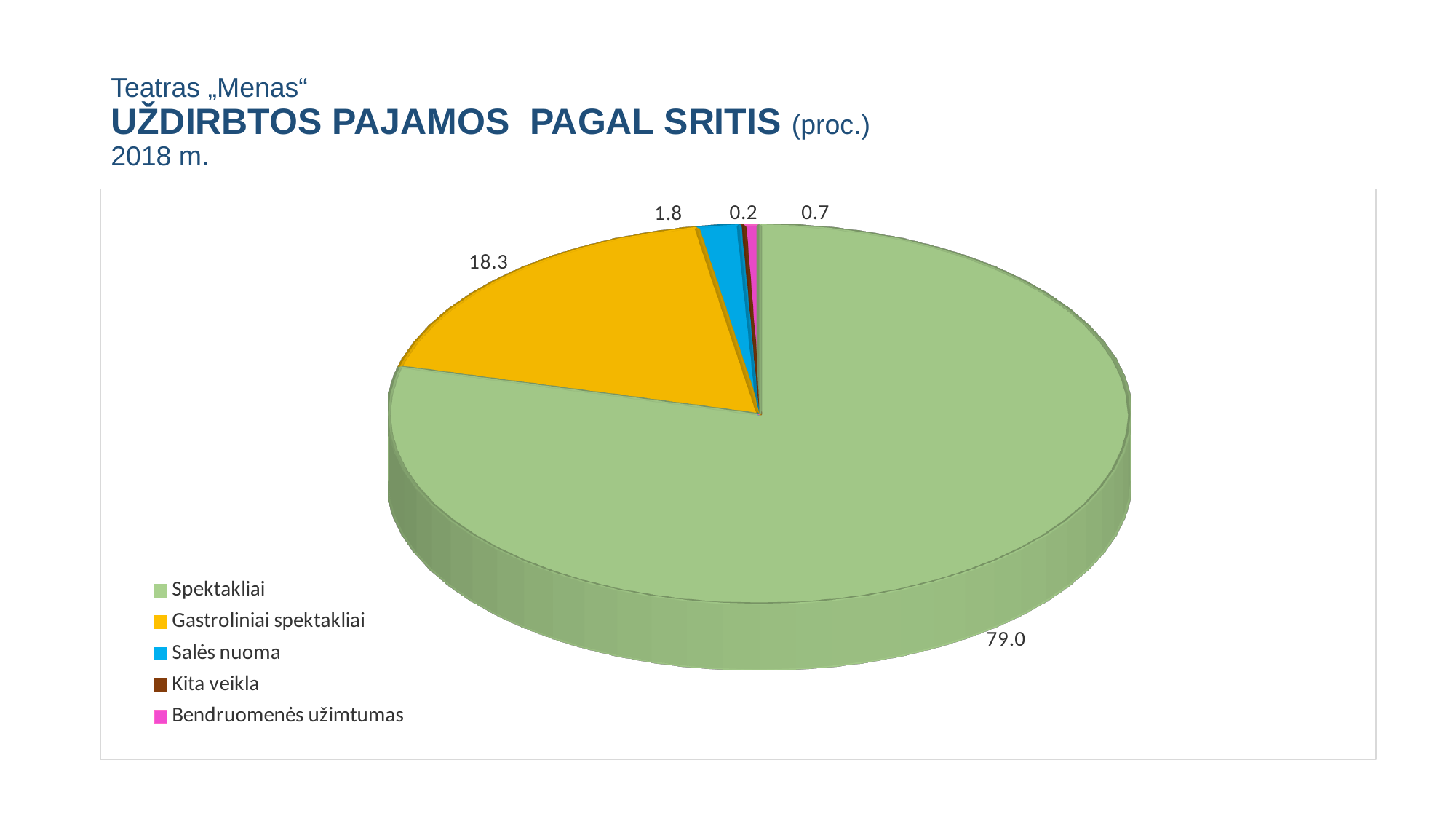
What kind of chart is shown on the slide? pie chart What is the value for Bendruomenės užimtumas? 0.7 Which category has the smallest share of the pie? Kita veikla Which is larger, the value for Salės nuoma or the value for Bendruomenės užimtumas? Salės nuoma How many categories does the legend list? 5 What is the value for Kita veikla? 0.2 What is the value for Salės nuoma? 1.8 What is the value for Gastroliniai spektakliai? 18.3 What colour is the slice for Gastroliniai spektakliai? yellow Which category has the largest share of the pie? Spektakliai What is the difference between the values for Spektakliai and Gastroliniai spektakliai? 60.7 What is the value for Spektakliai? 79.0